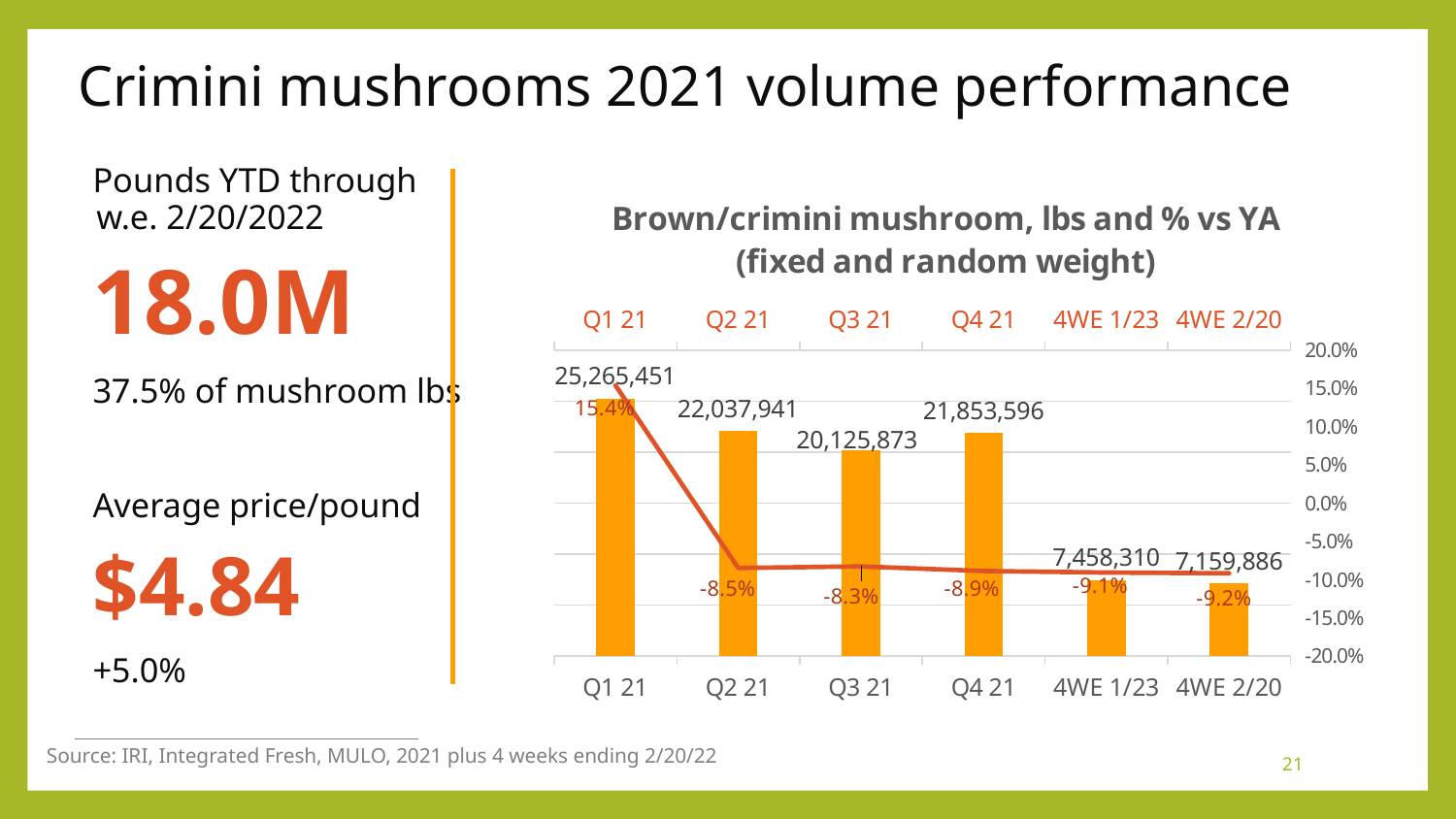
What is the pounds value for Q1 21? 25,265,451 What is the difference in pounds between Q2 21 and Q3 21? 1,912,068 Which has a higher pounds value, Q2 21 or Q4 21? Q2 21 What is the % vs YA value for 4WE 2/20? -9.2% How many periods are shown on the x axis? 6 What is the pounds value for Q3 21? 20,125,873 What kind of chart is this? Combined bar and line chart What is the % vs YA value for Q1 21? 15.4% What is the title of the chart? Brown/crimini mushroom, lbs and % vs YA (fixed and random weight) Which period has the highest pounds value? Q1 21 Which period has the lowest pounds value? 4WE 2/20 Does the % vs YA line rise or fall from Q1 21 to Q2 21? Fall